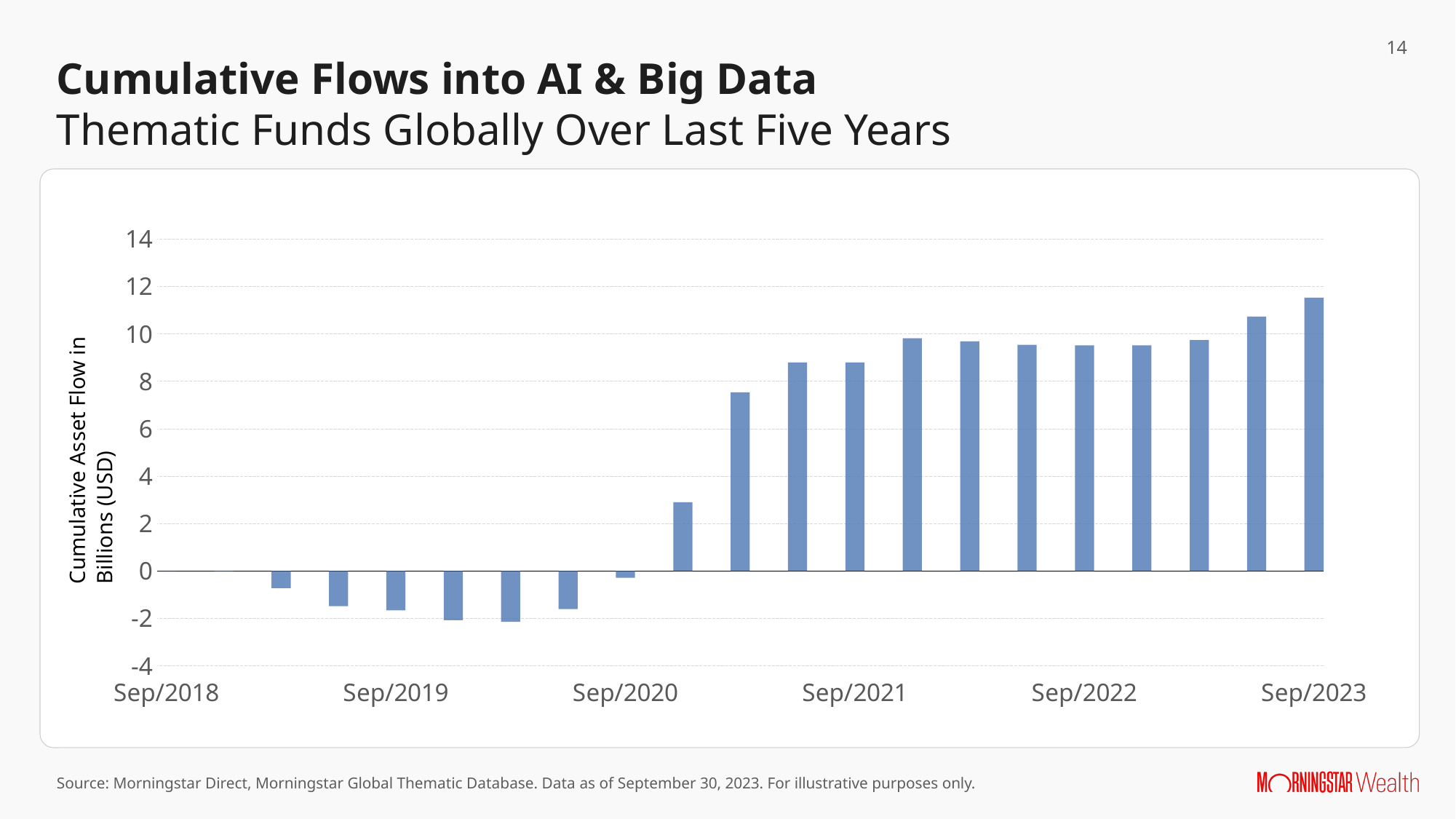
What kind of chart is shown on the slide? bar chart What is the label of the vertical axis? Cumulative Asset Flow in Billions (USD) Do the cumulative flows generally rise or fall from Sep/2020 to Sep/2023? rise Is the value for Sep/2021 greater or less than 8? greater Is the value for Sep/2022 greater or less than 8? greater Which is larger, the value for Sep/2023 or the value for Sep/2022? Sep/2023 Is the value for Sep/2019 greater or less than 0? less What is the first date label shown on the x axis? Sep/2018 Which labelled date on the x axis has the highest bar? Sep/2023